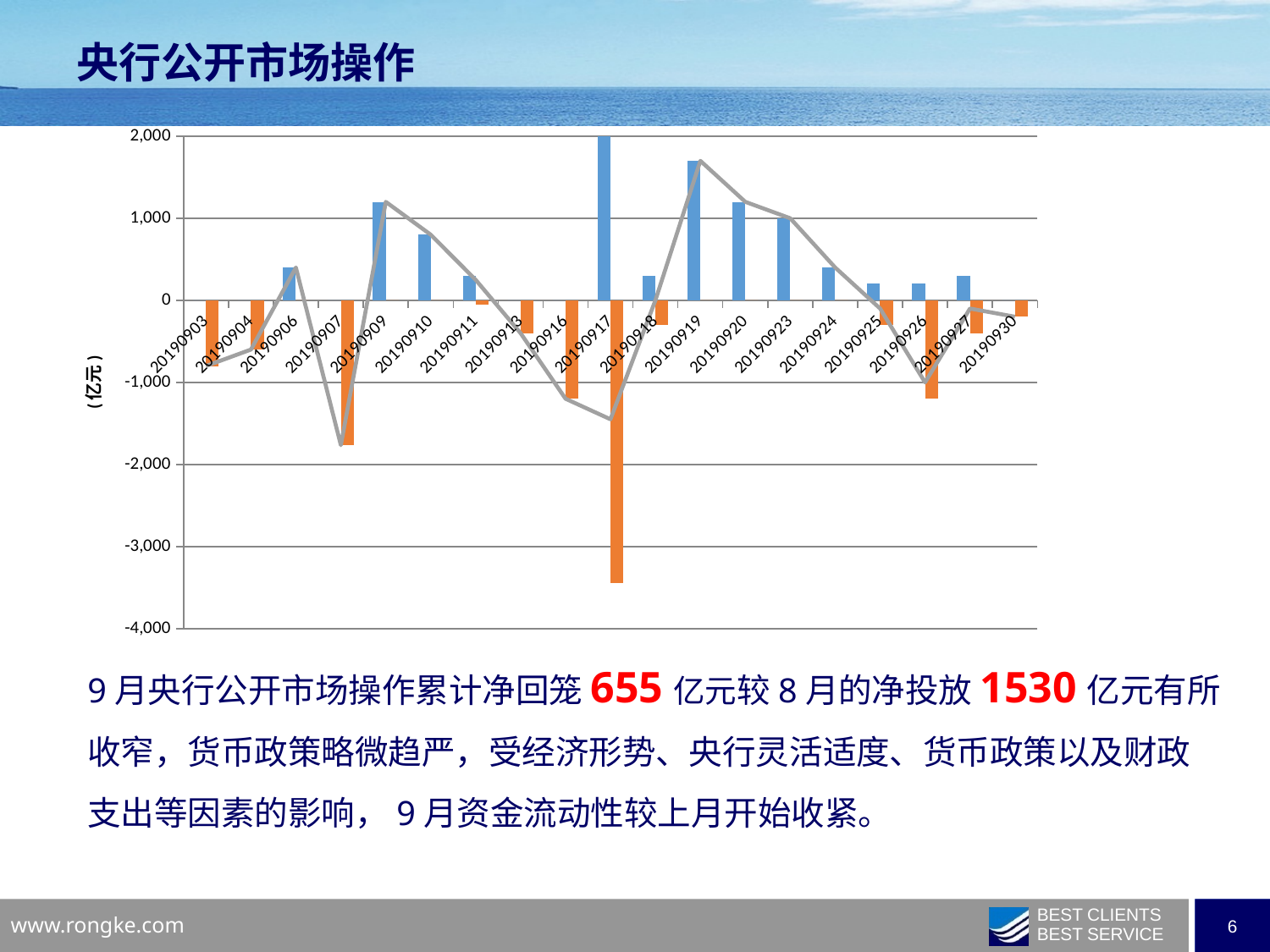
Does the grey line rise or fall from 20190917 to 20190919? rise What value does the blue bar for 20190923 reach on the axis? 1,000 Which blue bar is taller, 20190919 or 20190920? 20190919 What value does the blue bar for 20190917 reach on the axis? 2,000 On which date is the lowest (most negative) orange bar? 20190917 On which date is the tallest blue bar? 20190917 Is the blue bar for 20190909 greater or less than 1,000? greater What unit is shown on the vertical axis label of the chart? 亿元 How many dates are shown on the x axis of the chart? 19 Is the blue bar for 20190910 greater or less than 1,000? less Is the orange bar for 20190907 greater or less than -1,000? less What kind of chart is shown on the slide? bar chart with a line